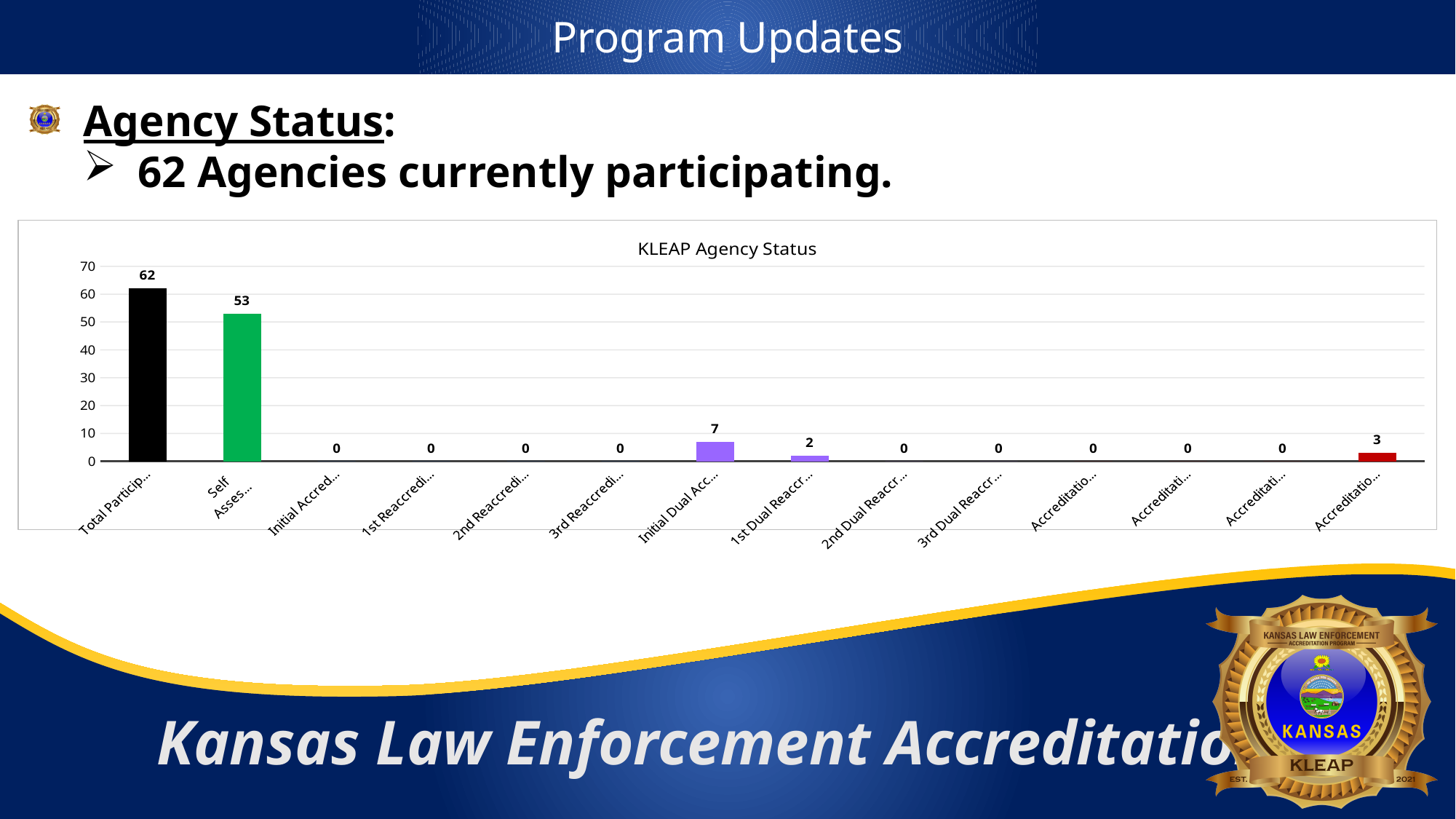
What is the difference between the "Total Particip..." bar and the "Self Asses..." bar? 9 What type of chart is shown on the slide? bar chart Which category has the highest value in the chart? Total Particip... What is the value of the rightmost (red) bar in the chart? 3 How many categories in the chart have a value of 0? 9 Which is larger, the value for "Initial Dual Acc..." or the value for "1st Dual Reaccr..."? Initial Dual Acc... What is the value of the first bar, labelled "Total Particip..."? 62 What is the title of the chart? KLEAP Agency Status What is the value of the bar labelled "Self Asses..."? 53 How many categories are shown on the x axis of the chart? 14 What is the value of the bar labelled "Initial Dual Acc..."? 7 What is the value of the bar labelled "1st Dual Reaccr..."? 2